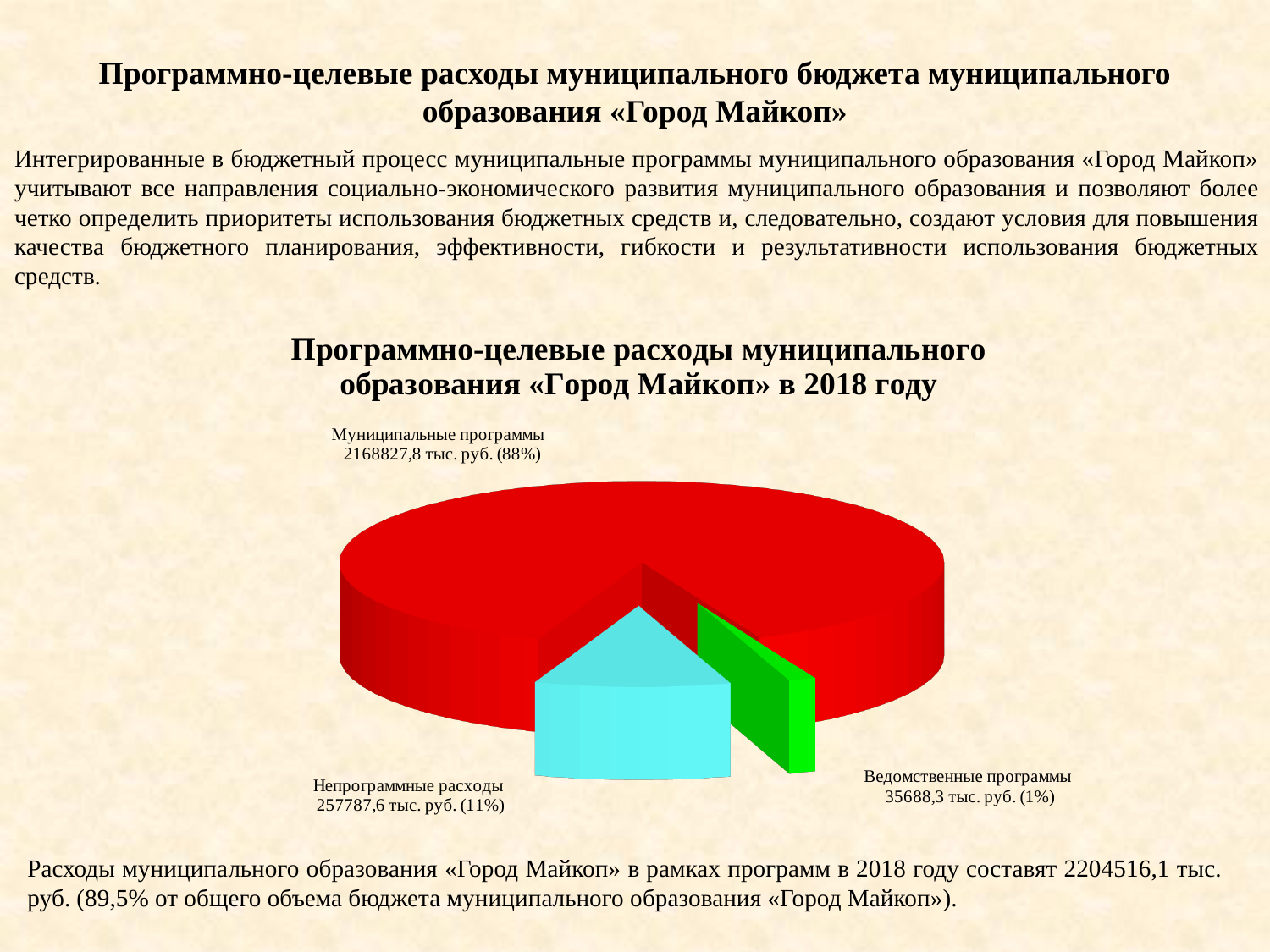
Which is larger: Непрограммные расходы or Ведомственные программы? Непрограммные расходы What is the value for Муниципальные программы in the pie chart? 2168827,8 тыс. руб. Which category has the largest slice in the pie chart? Муниципальные программы How many slices does the pie chart have? 3 What is the value for Непрограммные расходы in the pie chart? 257787,6 тыс. руб. Which category has the smallest slice in the pie chart? Ведомственные программы What is the difference between Непрограммные расходы and Ведомственные программы in тыс. руб.? 222099,3 тыс. руб. What share of the pie does Непрограммные расходы represent? 11% What share of the pie does Муниципальные программы represent? 88% What is the title of the pie chart? Программно-целевые расходы муниципального образования «Город Майкоп» в 2018 году What is the value for Ведомственные программы in the pie chart? 35688,3 тыс. руб. What type of chart is shown on the slide? Pie chart